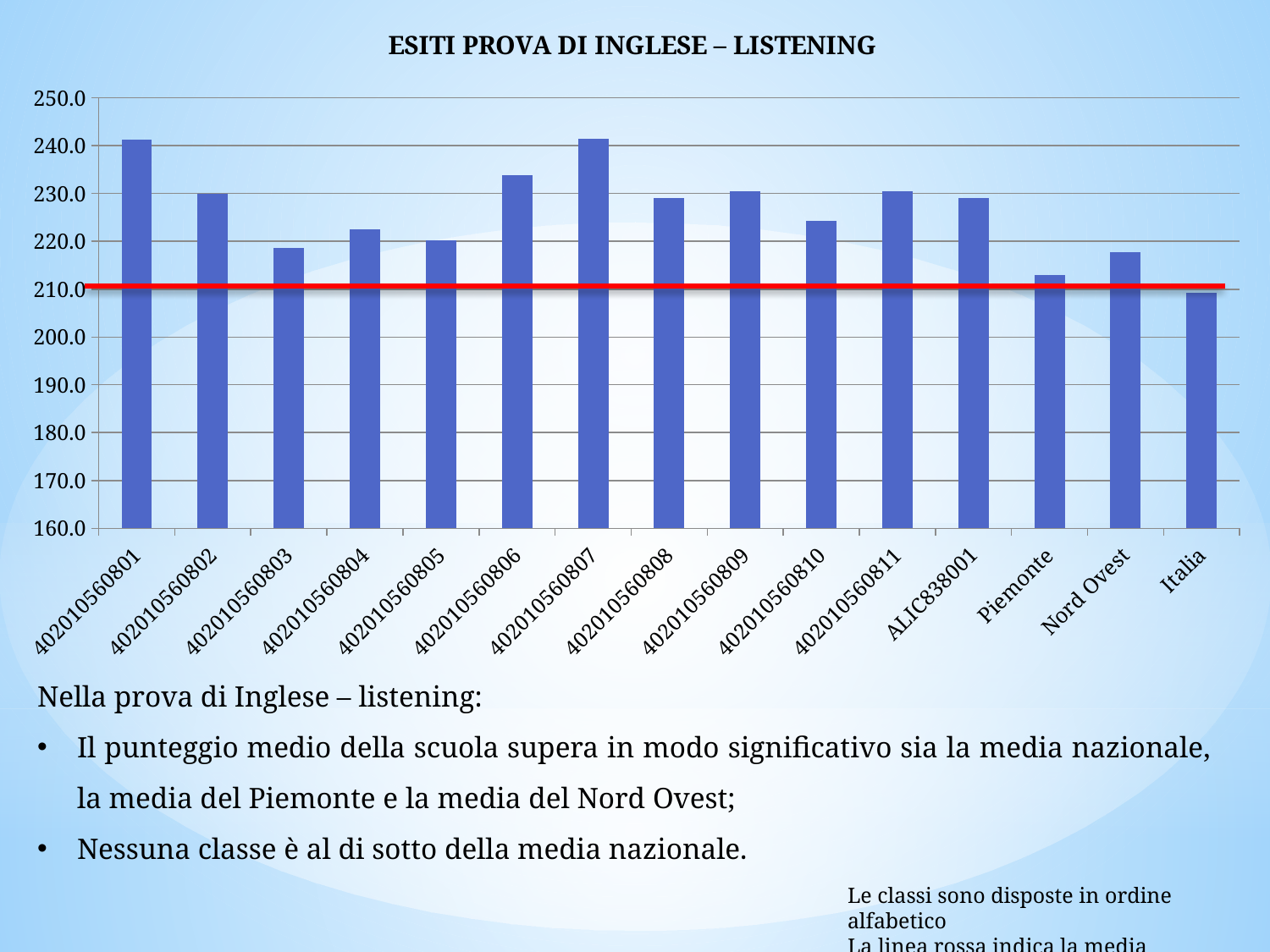
Is the value for Piemonte greater or less than 220? less Which is larger, the value for 402010560806 or the value for 402010560805? 402010560806 What kind of chart is shown on the slide? bar chart How many categories are plotted along the x axis? 15 Is the value for Italia greater or less than 220? less Is the value for 402010560801 greater or less than 230? greater What colour are the bars in the chart? blue Which category has the lowest value? Italia What is the title of the chart? ESITI PROVA DI INGLESE – LISTENING Which is larger, the value for Nord Ovest or the value for Piemonte? Nord Ovest